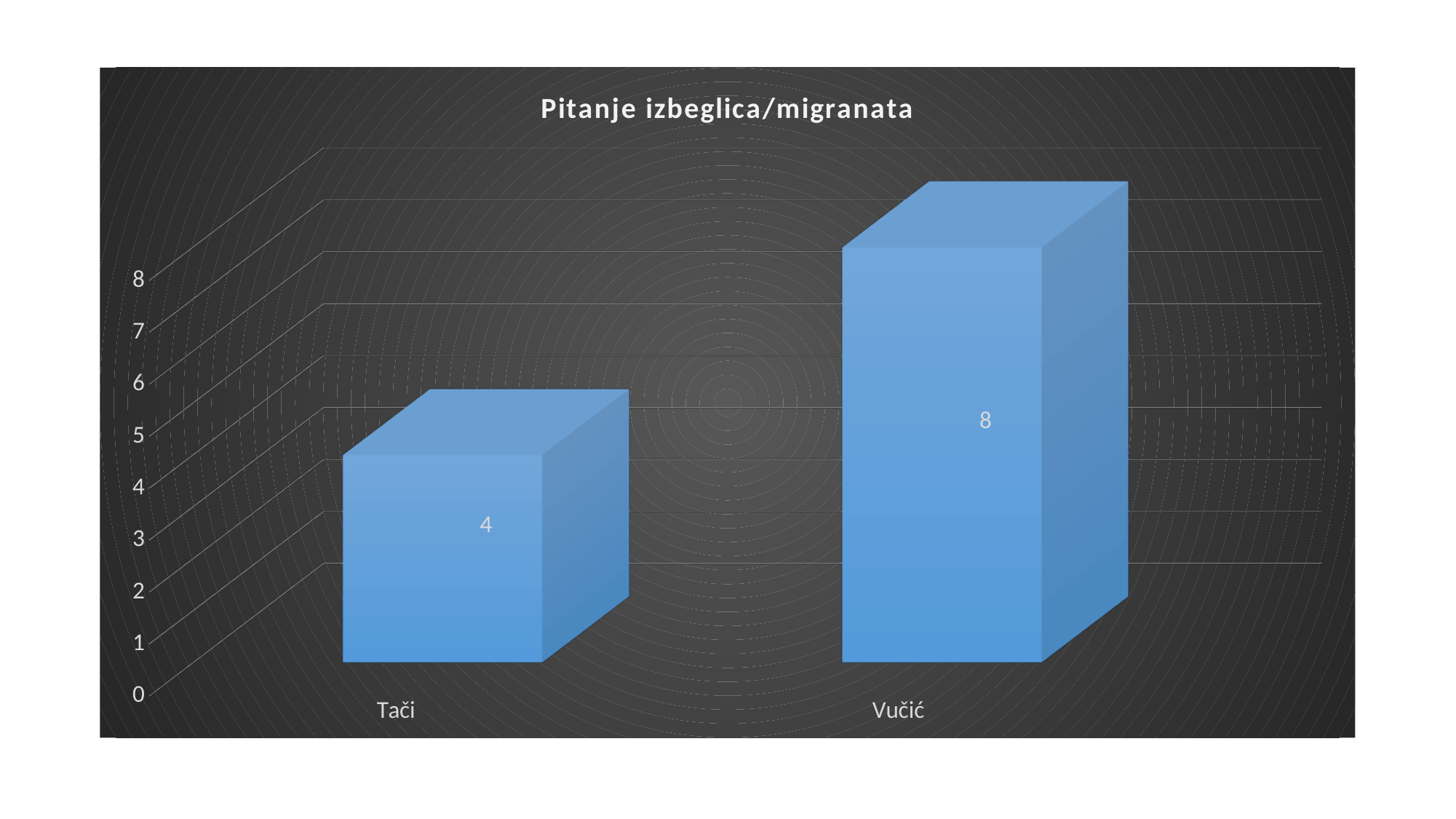
What is the difference between the values for Vučić and Tači? 4 Is the value for Vučić greater or less than 6? greater What kind of chart is shown on the slide? bar chart What is the value for Vučić? 8 What is the value for Tači? 4 Which category has the highest value? Vučić Which is larger, the value for Tači or the value for Vučić? Vučić How many categories are shown in the chart? 2 What is the highest value shown on the vertical axis? 8 Which category has the lowest value? Tači What is the title of the chart? Pitanje izbeglica/migranata Is the value for Tači greater or less than 5? less